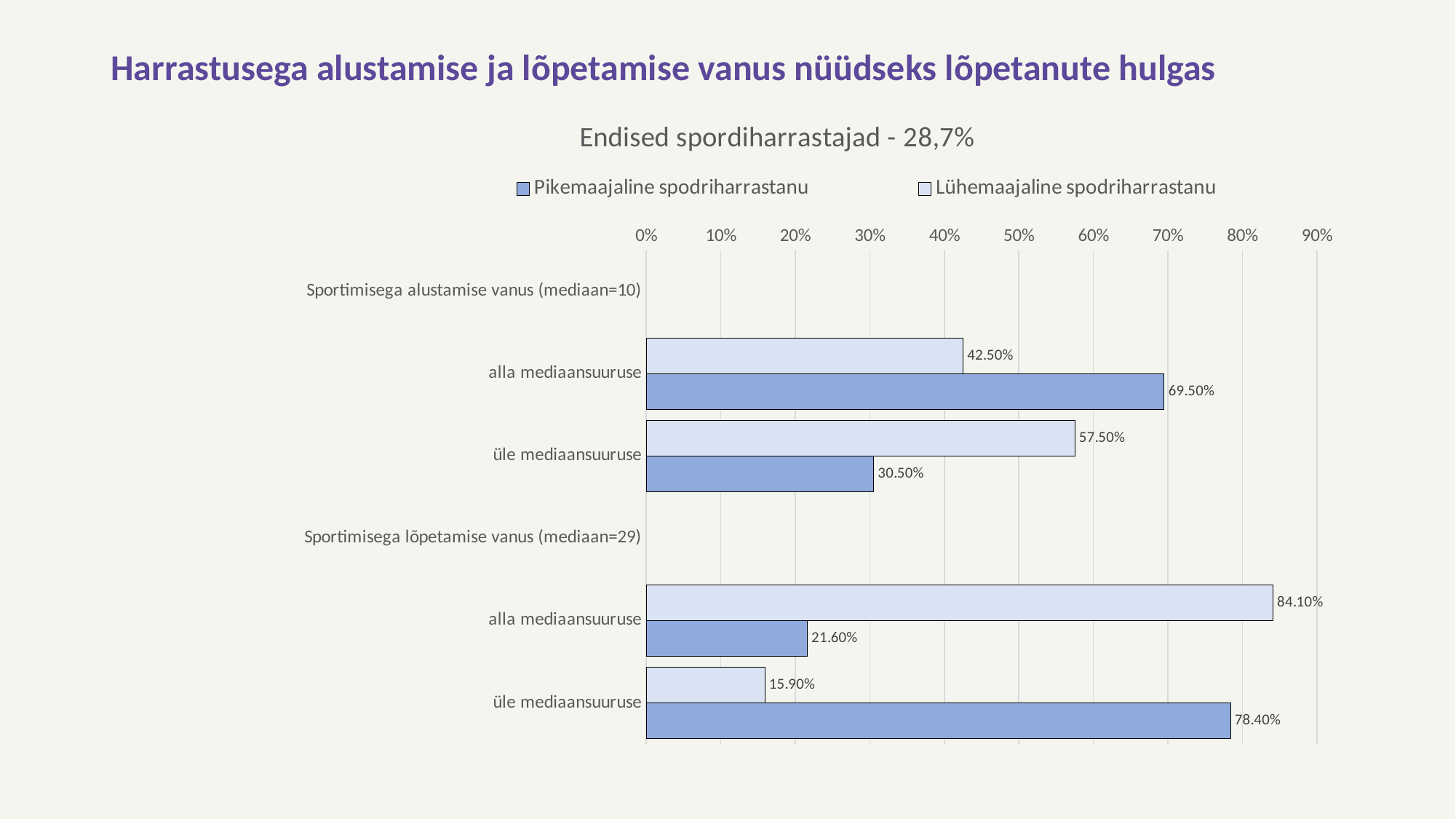
Which bar has the lowest value in the chart? Lühemaajaline spodriharrastanu, üle mediaansuuruse (Sportimisega lõpetamise vanus), 15.90% Under 'Sportimisega alustamise vanus (mediaan=10)', what is the difference between the Lühemaajaline and Pikemaajaline values in the 'üle mediaansuuruse' category? 27.00 percentage points What kind of chart is shown on the slide? bar chart Under 'Sportimisega lõpetamise vanus (mediaan=29)', what is the value for Lühemaajaline spodriharrastanu in the 'alla mediaansuuruse' category? 84.10% Under 'Sportimisega alustamise vanus (mediaan=10)', what is the value for Lühemaajaline spodriharrastanu in the 'üle mediaansuuruse' category? 57.50% What is the chart's title? Endised spordiharrastajad - 28,7% How many series does the legend list? 2 Under 'Sportimisega lõpetamise vanus (mediaan=29)', what is the value for Pikemaajaline spodriharrastanu in the 'üle mediaansuuruse' category? 78.40% Under 'Sportimisega alustamise vanus (mediaan=10)', what is the difference between the Pikemaajaline and Lühemaajaline values in the 'alla mediaansuuruse' category? 27.00 percentage points Under 'Sportimisega alustamise vanus (mediaan=10)', what is the value for Pikemaajaline spodriharrastanu in the 'alla mediaansuuruse' category? 69.50% Which bar has the highest value in the chart? Lühemaajaline spodriharrastanu, alla mediaansuuruse (Sportimisega lõpetamise vanus), 84.10% Under 'Sportimisega lõpetamise vanus (mediaan=29)', in the 'üle mediaansuuruse' category, which series has the larger value? Pikemaajaline spodriharrastanu